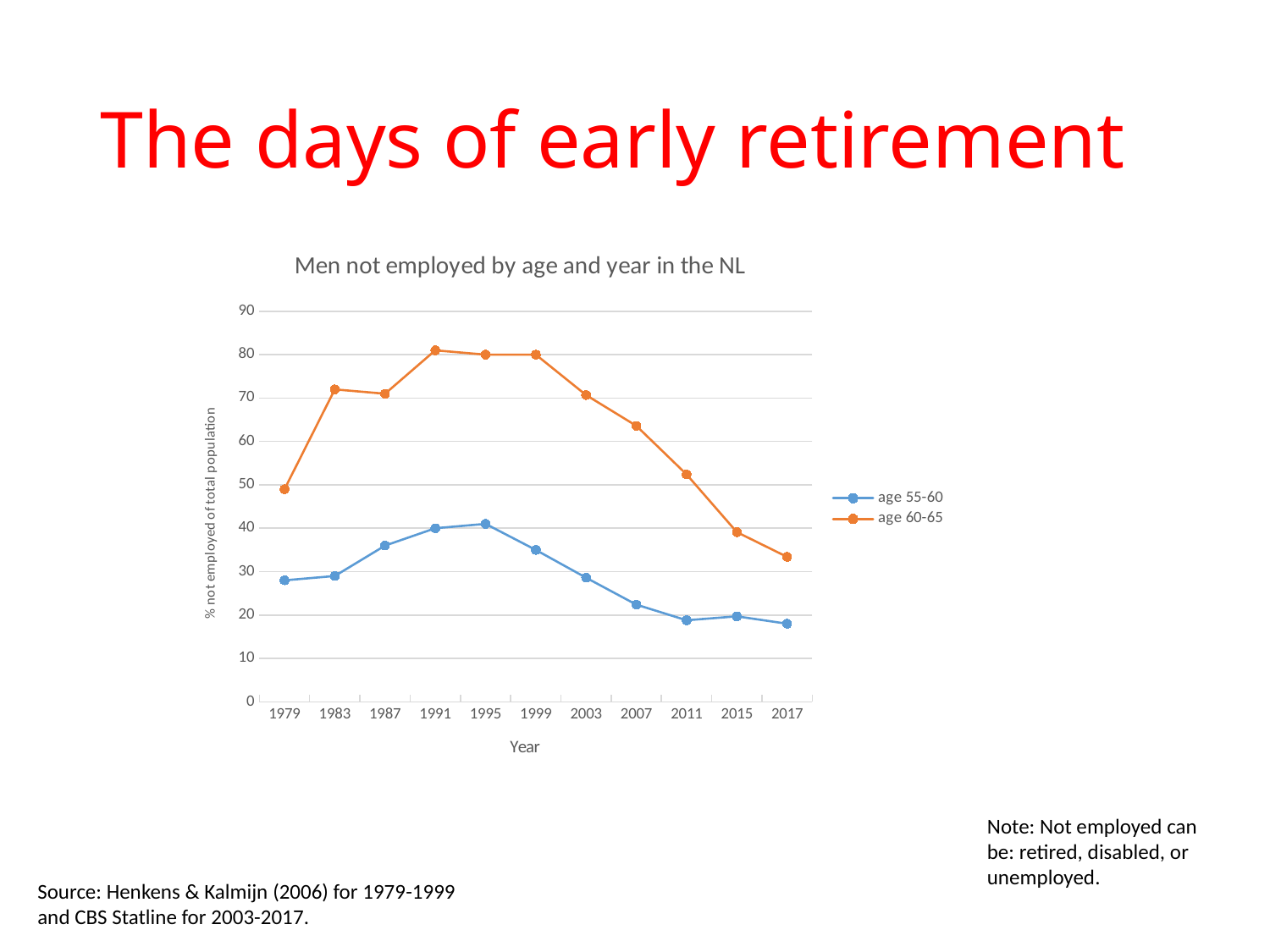
Is the value for age 55-60 in 2017 greater or less than 20? less Is the value for age 60-65 in 2007 greater or less than 60? greater In which year is the value for age 60-65 lowest? 2017 How many years are plotted along the x axis? 11 Which series is drawn in orange? age 60-65 What kind of chart is shown on the slide? line chart What is the title of the chart? Men not employed by age and year in the NL Is the value for age 60-65 in 1979 greater or less than 60? less In 1983, which series has the higher value, age 55-60 or age 60-65? age 60-65 How many series does the legend list? 2 Do the values for age 60-65 rise or fall from 1999 to 2017? fall